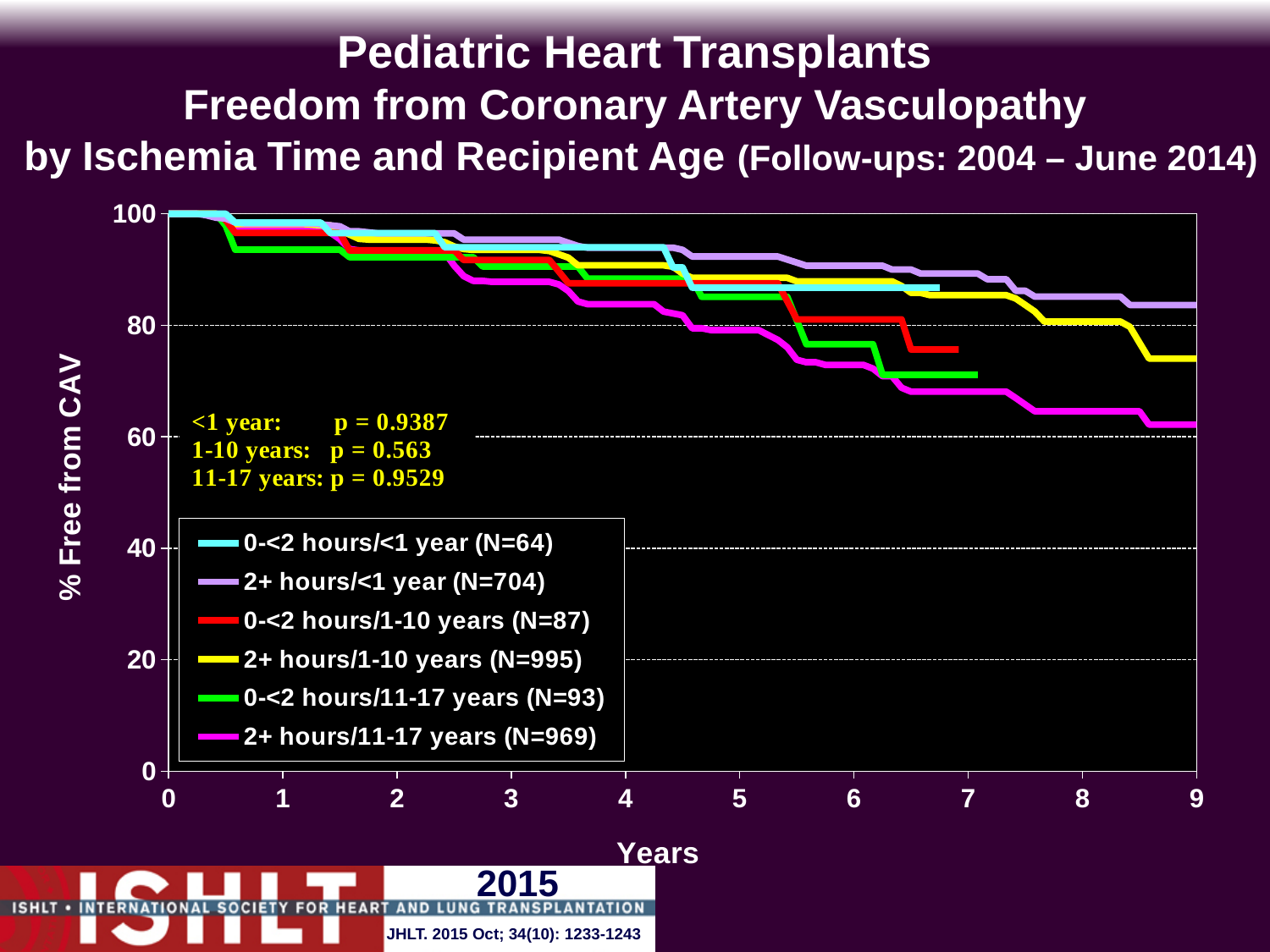
Which series has the lowest value at year 9? 2+ hours/11-17 years Is the value for 2+ hours/<1 year at year 9 greater or less than 80? greater At year 9, which is higher: 2+ hours/<1 year or 2+ hours/11-17 years? 2+ hours/<1 year What is the N shown in the legend for 2+ hours/1-10 years? N=995 Is the value for 2+ hours/11-17 years at year 9 greater or less than 80? less What kind of chart is shown on the slide? line chart What is the label of the x axis? Years How many series does the legend list? 6 Do the curves rise or fall as the years increase along the x axis? fall What p-value is shown for the <1 year comparison? p = 0.9387 Which series has the highest value at year 9? 2+ hours/<1 year Is the value for 2+ hours/1-10 years at year 9 greater or less than 60? greater